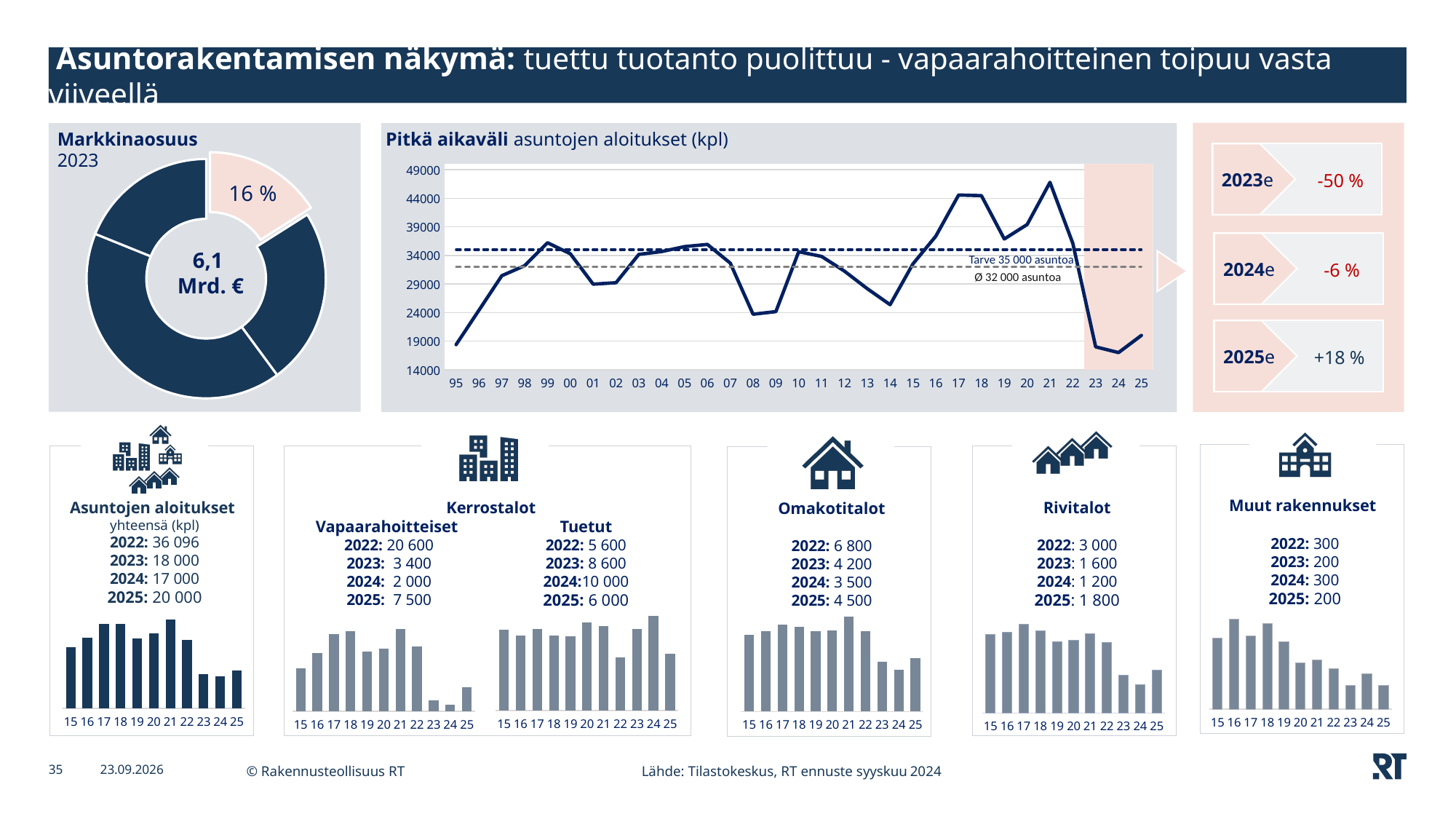
In the Markkinaosuus 2023 donut chart, what share does the highlighted (light) slice represent? 16 % In the Omakotitalot chart, what is the difference between the 2022 and 2023 values? 2 600 In the Kerrostalot chart, what is the Tuetut value for 2024? 10 000 In the Kerrostalot chart, which is larger for 2022: Vapaarahoitteiset or Tuetut? Vapaarahoitteiset In the 'Pitkä aikaväli asuntojen aloitukset (kpl)' line chart, what value does the dashed line labelled 'Tarve' mark? 35 000 asuntoa In the 'Asuntojen aloitukset yhteensä (kpl)' chart, what is the value for 2022? 36 096 How many bars does the Rivitalot bar chart show? 11 In the 'Pitkä aikaväli asuntojen aloitukset (kpl)' line chart, is the value for 23 greater or less than 19000? less What kind of chart is the 'Pitkä aikaväli asuntojen aloitukset (kpl)' chart? line chart In the 'Pitkä aikaväli asuntojen aloitukset (kpl)' line chart, is the value for 21 greater or less than 44000? greater In the 'Pitkä aikaväli asuntojen aloitukset (kpl)' line chart, does the line rise or fall from 22 to 23? fall What value is printed in the centre of the Markkinaosuus 2023 donut chart? 6,1 Mrd. €